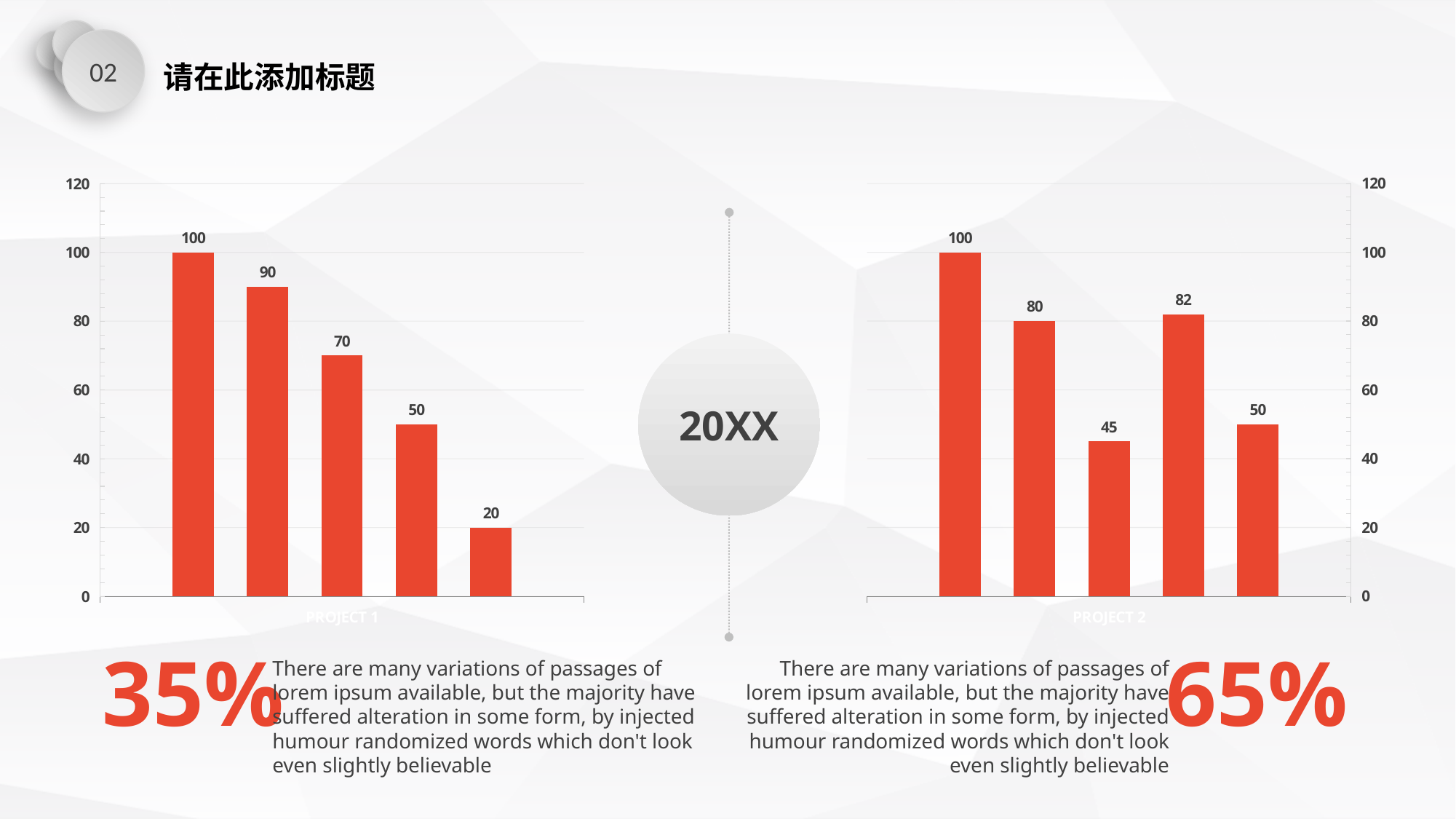
On the right chart (PROJECT 2), which is larger, the second bar or the fifth bar? The second bar (80) On the right chart (PROJECT 2), what is the difference between the second bar (80) and the fourth bar (82)? 2 What is the maximum value shown on the vertical axis of the right chart (PROJECT 2)? 120 On the right chart (PROJECT 2), what is the value of the third bar? 45 On the left chart (PROJECT 1), what is the value of the last bar? 20 On the right chart (PROJECT 2), which bar has the lowest value? The third bar (45) On the left chart (PROJECT 1), what is the difference between the first bar and the last bar? 80 On the left chart (PROJECT 1), what is the value of the first bar? 100 On the left chart (PROJECT 1), do the bar values rise or fall from left to right? Fall On the right chart (PROJECT 2), what is the value of the fourth bar? 82 What type of chart is shown on the left side of the slide? Bar chart On the left chart (PROJECT 1), how many bars are plotted? 5